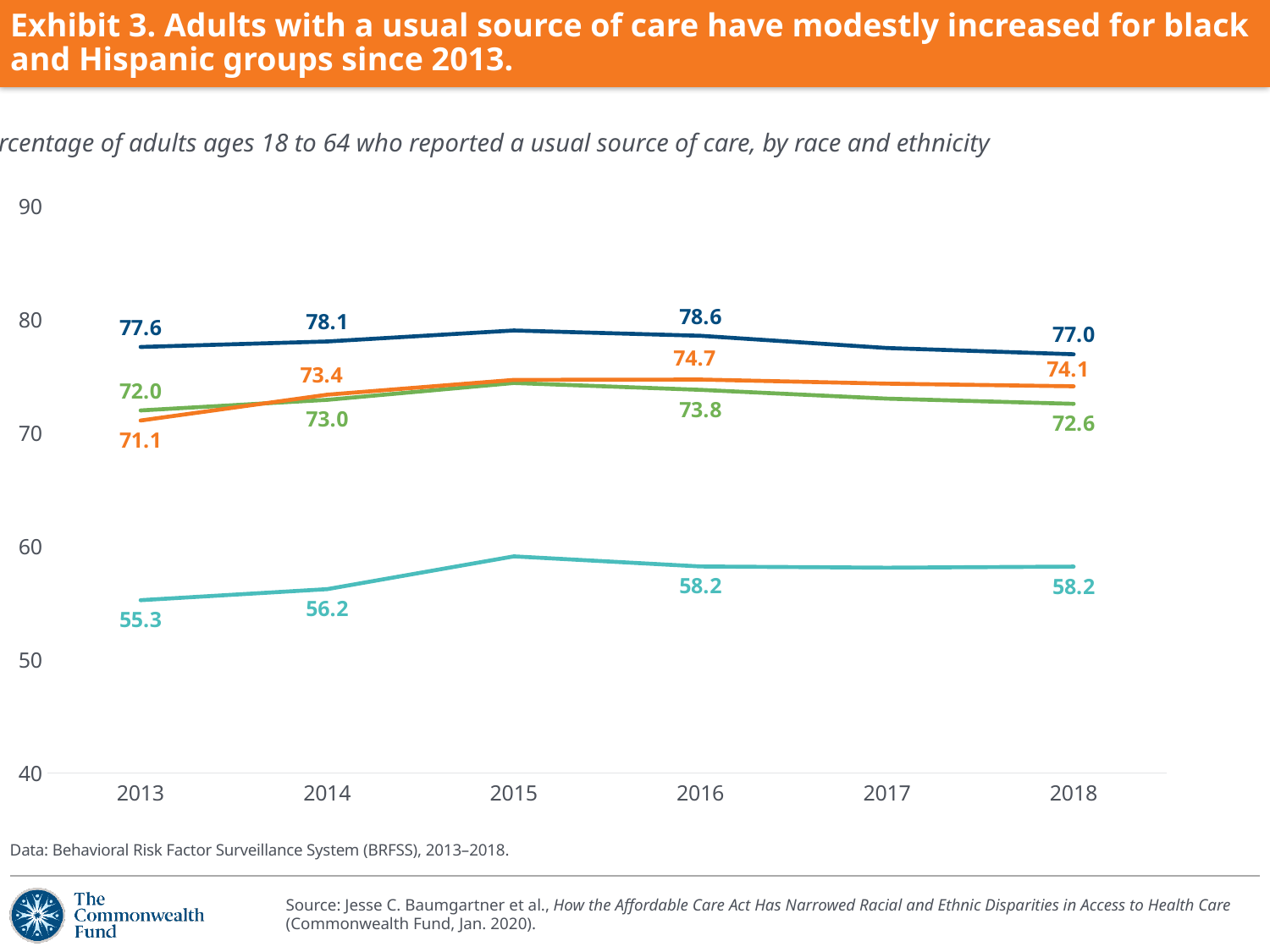
What is the value of the green line in 2014? 73.0 What is the lowest labeled value on the chart? 55.3 What is the value of the orange line in 2016? 74.7 Which year has the highest labeled value on the dark blue line? 2016 Is the value of the teal (light blue) line in 2015 greater or less than 60? less How many years are shown on the x axis of the chart? 6 In 2013, which is larger: the value of the green line or the value of the orange line? green line What is the value of the dark blue line in 2013? 77.6 What kind of chart is shown on the slide? line chart What is the value of the teal (light blue) line in 2018? 58.2 Does the teal (light blue) line rise or fall from 2013 to 2016? rise What is the difference between the orange line's value in 2018 and its value in 2013? 3.0